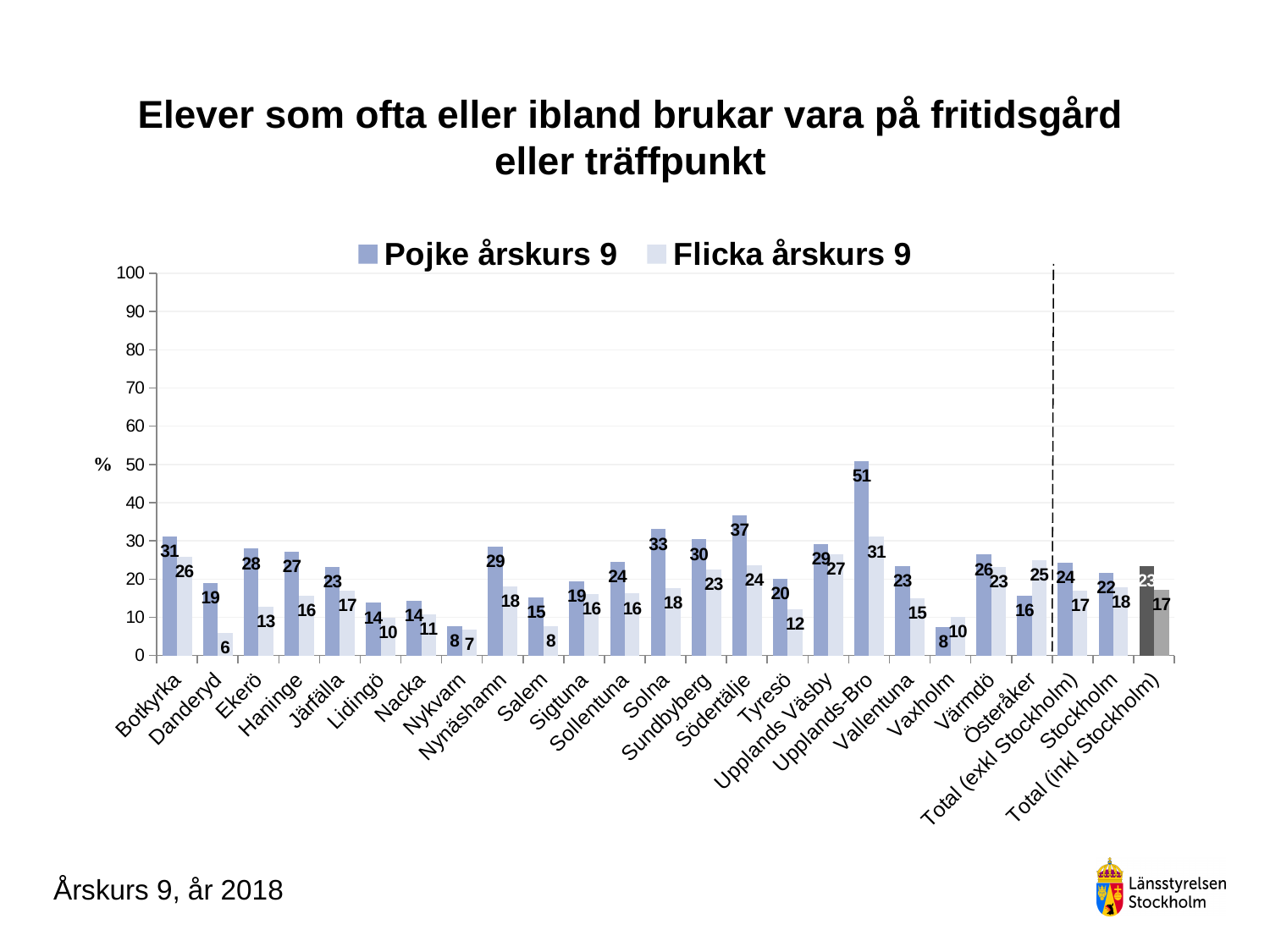
Which category has the lowest value for Flicka årskurs 9? Danderyd What is the value for Flicka årskurs 9 in Danderyd? 6 What is the value for Flicka årskurs 9 in Total (inkl Stockholm)? 17 Which is larger in Österåker: the value for Pojke årskurs 9 or Flicka årskurs 9? Flicka årskurs 9 Is the value for Pojke årskurs 9 in Solna greater or less than 20? greater What is the value for Pojke årskurs 9 in Södertälje? 37 How many categories are shown on the x axis? 25 What is the difference between the Pojke årskurs 9 and Flicka årskurs 9 values in Upplands-Bro? 20 How many series does the legend list? 2 What kind of chart is shown on the slide? Bar chart Which category has the highest value for Pojke årskurs 9? Upplands-Bro What is the value for Pojke årskurs 9 in Upplands-Bro? 51